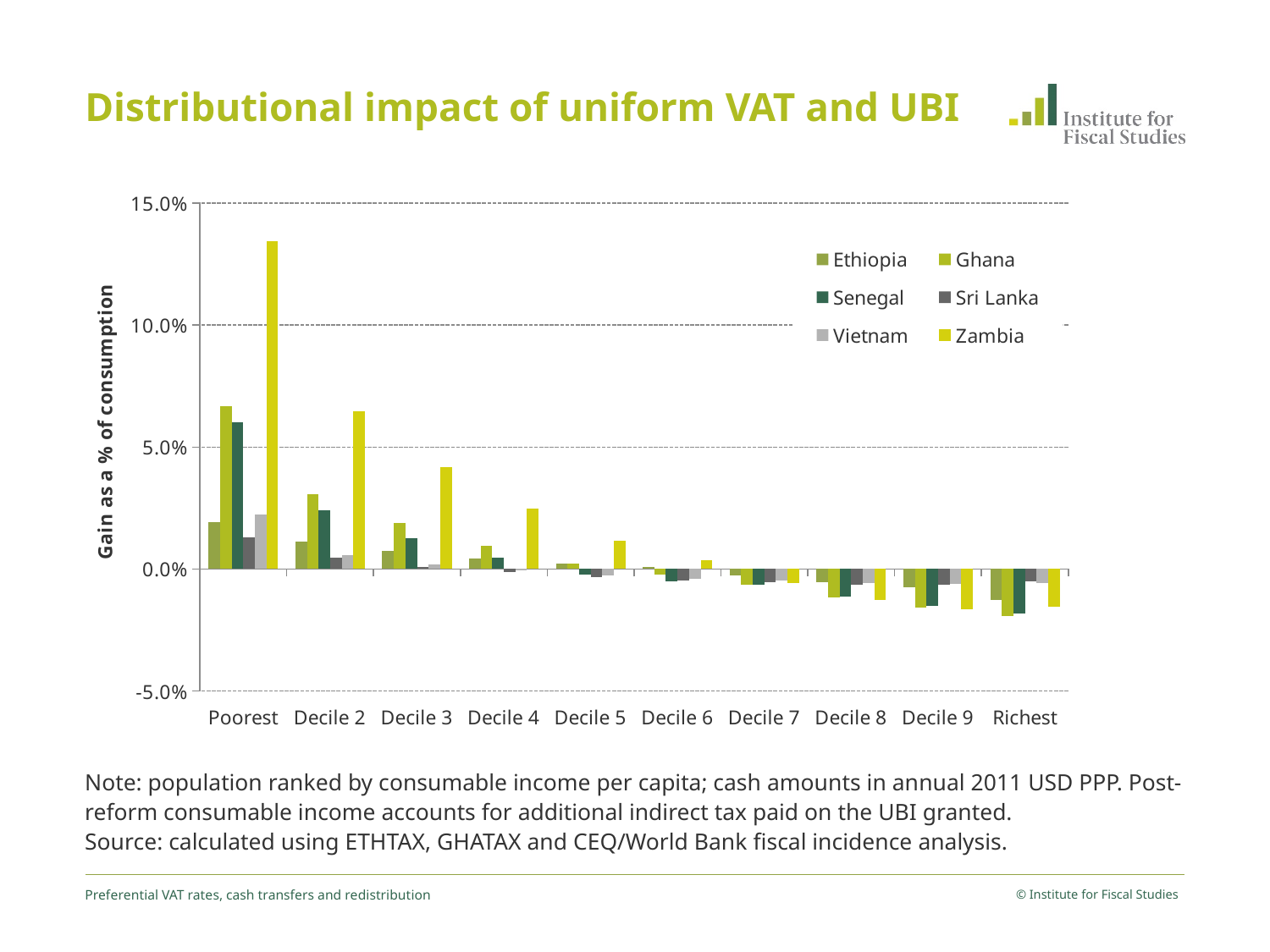
What kind of chart is shown on the slide? Bar chart Is the value for Zambia in Decile 2 greater or less than 5.0%? greater In the Poorest decile, which is larger: the value for Ethiopia or the value for Sri Lanka? Ethiopia Is the value for Zambia in Decile 3 greater or less than 5.0%? less In Decile 2, which is larger: the value for Zambia or the value for Ghana? Zambia How many series does the legend list? 6 Do the values for Zambia rise or fall moving from Poorest to Richest? fall What is the title of the vertical axis? Gain as a % of consumption Is the value for Zambia in the Poorest decile greater or less than 10.0%? greater Which country has the highest gain for the Poorest decile? Zambia How many decile categories are shown on the x axis? 10